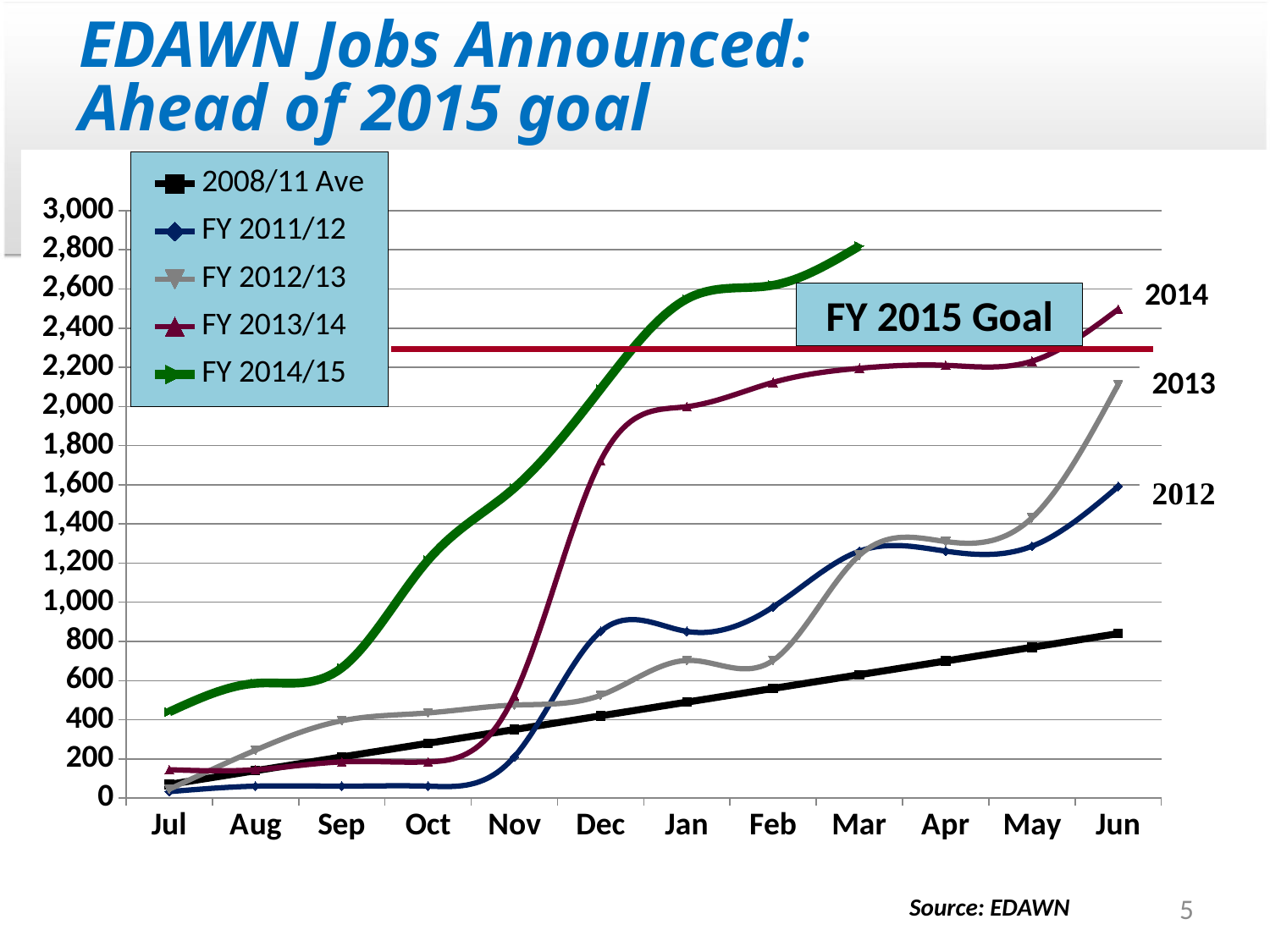
Is the value for 2008/11 Ave in Jun greater or less than 1,000? less Is the value for FY 2014/15 in Mar greater or less than 2,600? greater Is the value for FY 2013/14 in Jun greater or less than 2,200? greater Which series has the highest value in Mar? FY 2014/15 What kind of chart is shown on the slide? Line chart How many months are shown along the x axis? 12 Does the 2008/11 Ave series rise or fall from Jul to Jun? Rise Which series is drawn in green? FY 2014/15 How many series does the legend list? 5 In Dec, which series has the larger value, FY 2014/15 or FY 2013/14? FY 2014/15